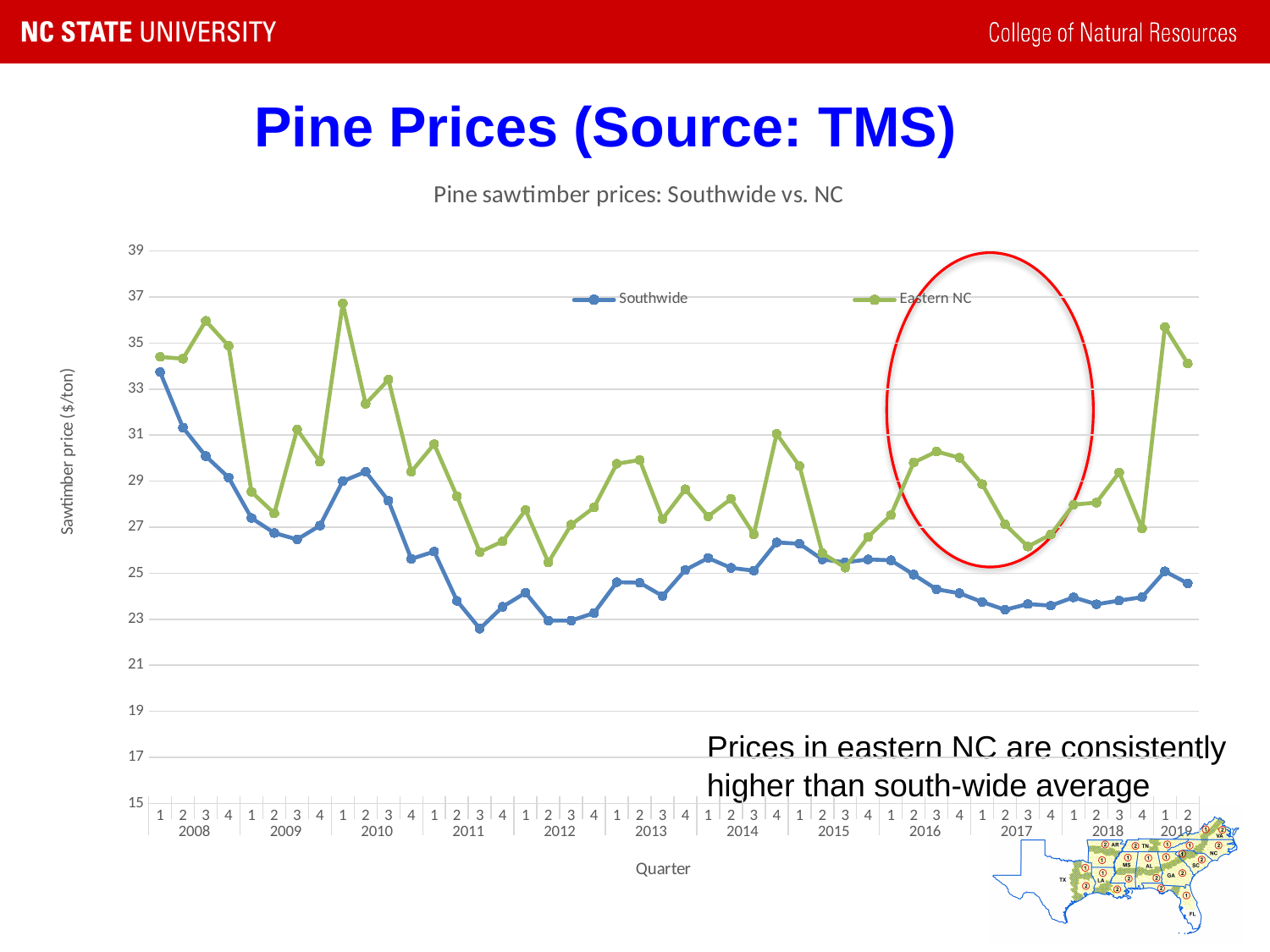
Is the Southwide value in quarter 1 of 2008 greater or less than 33? greater Does the Southwide series rise or fall from quarter 1 of 2008 to quarter 3 of 2011? fall What kind of chart is shown on the slide? line chart Is the Eastern NC value in quarter 1 of 2010 greater or less than 35? greater How many years are labelled on the x axis? 12 Is the Southwide value in quarter 3 of 2011 greater or less than 23? less What are the two series named in the legend? Southwide and Eastern NC What is the title of the chart? Pine sawtimber prices: Southwide vs. NC In quarter 1 of 2010, which series has the higher value, Southwide or Eastern NC? Eastern NC How many series does the legend list? 2